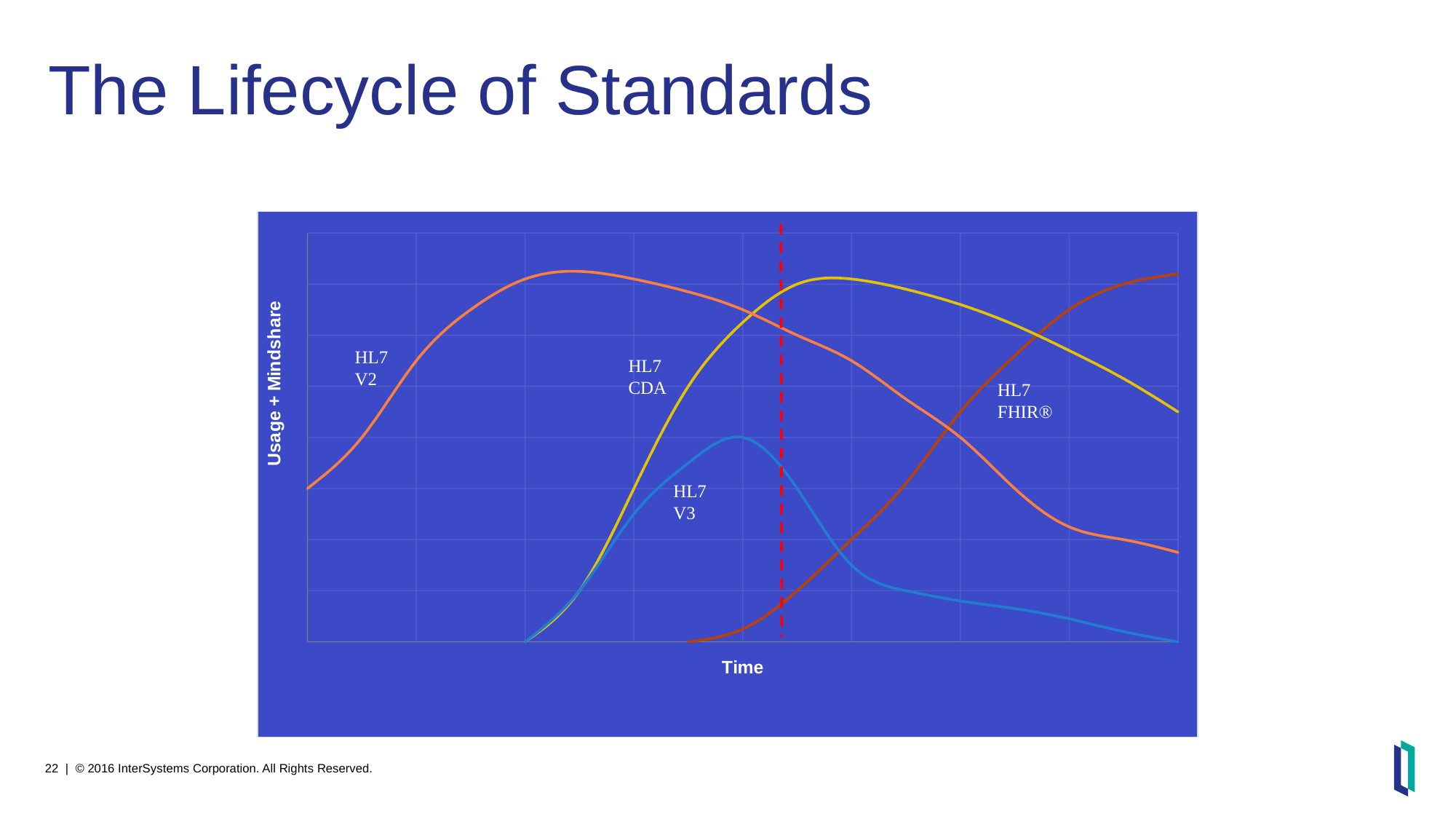
What is the label of the vertical axis? Usage + Mindshare What kind of chart is shown on the slide? Line chart Which standard's curve begins earliest along the time axis? HL7 V2 Which standard's curve reaches the lowest peak? HL7 V3 Which standard's curve is still rising at the right end of the chart? HL7 FHIR At the right edge of the chart, which is higher: HL7 CDA or HL7 V3? HL7 CDA Does the HL7 V3 curve rise or fall after the red dashed line? Fall How many standards (curves) are plotted on the chart? 4 Does the HL7 V2 curve rise or fall over the right half of the chart? Fall Which standard's curve is highest at the right edge of the chart? HL7 FHIR What is the label of the horizontal axis? Time Which standard's curve starts latest along the time axis? HL7 FHIR